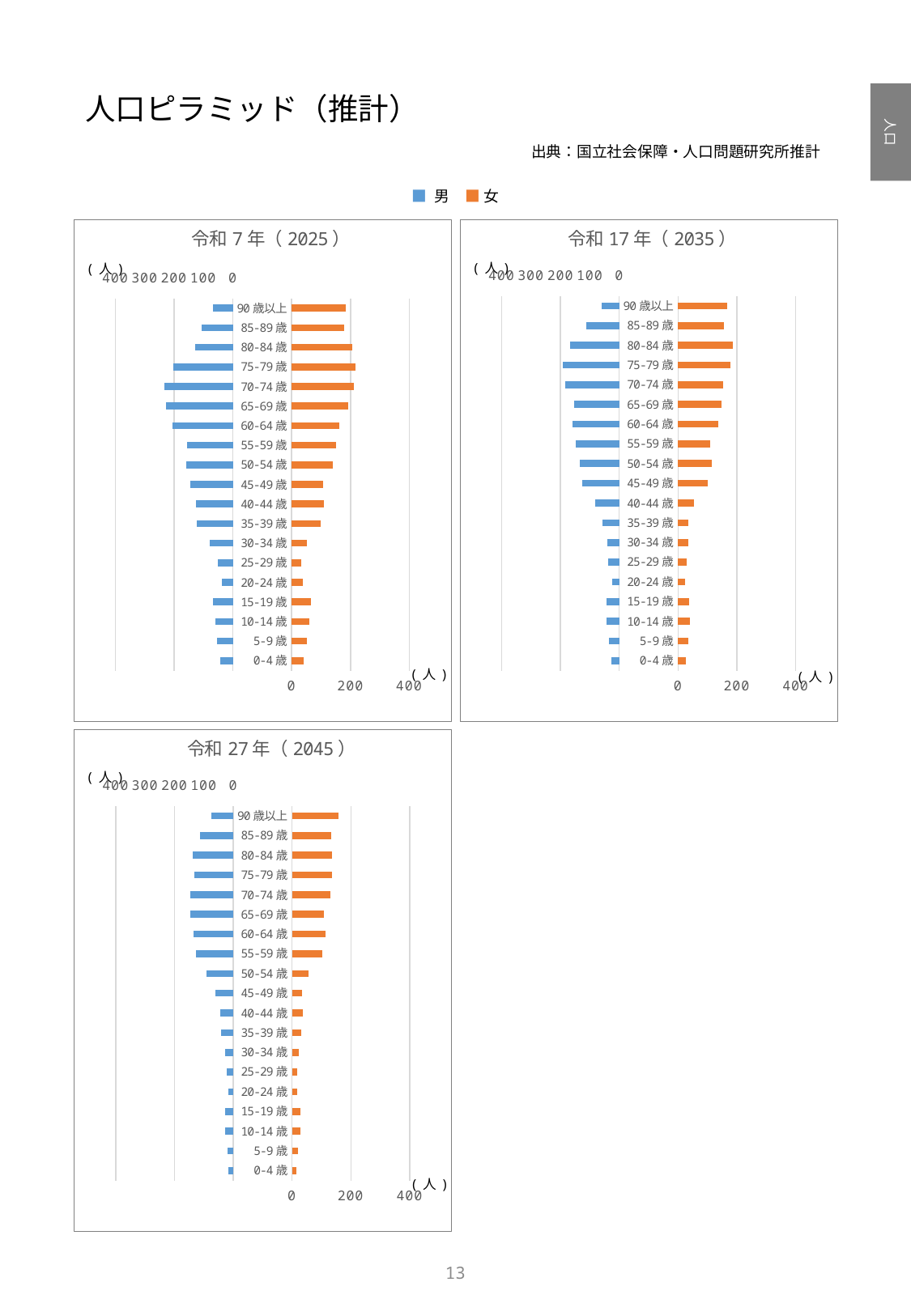
How many series does the legend list for the population pyramid charts? 2 How many population pyramid charts are on the slide? 3 In the 令和7年（2025） chart, is the 女 value for 0-4歳 greater or less than 100? less In the 令和17年（2035） chart, which is larger, the 男 value for 75-79歳 or the 男 value for 35-39歳? 75-79歳 In the 令和27年（2045） chart, which age group has the highest 女 value? 90歳以上 What kind of chart is the 令和7年（2025） chart? bar chart What are the two series named in the legend? 男 and 女 How many age groups are shown in the 令和17年（2035） chart? 19 In the 令和27年（2045） chart, do the 女 values generally increase or decrease going from the 0-4歳 group up to the 90歳以上 group? increase In the 令和7年（2025） chart, which age group has the highest 女 value? 75-79歳 In the 令和7年（2025） chart, is the 男 value for 70-74歳 greater or less than 100? greater In the 令和17年（2035） chart, which age group has the highest 女 value? 80-84歳